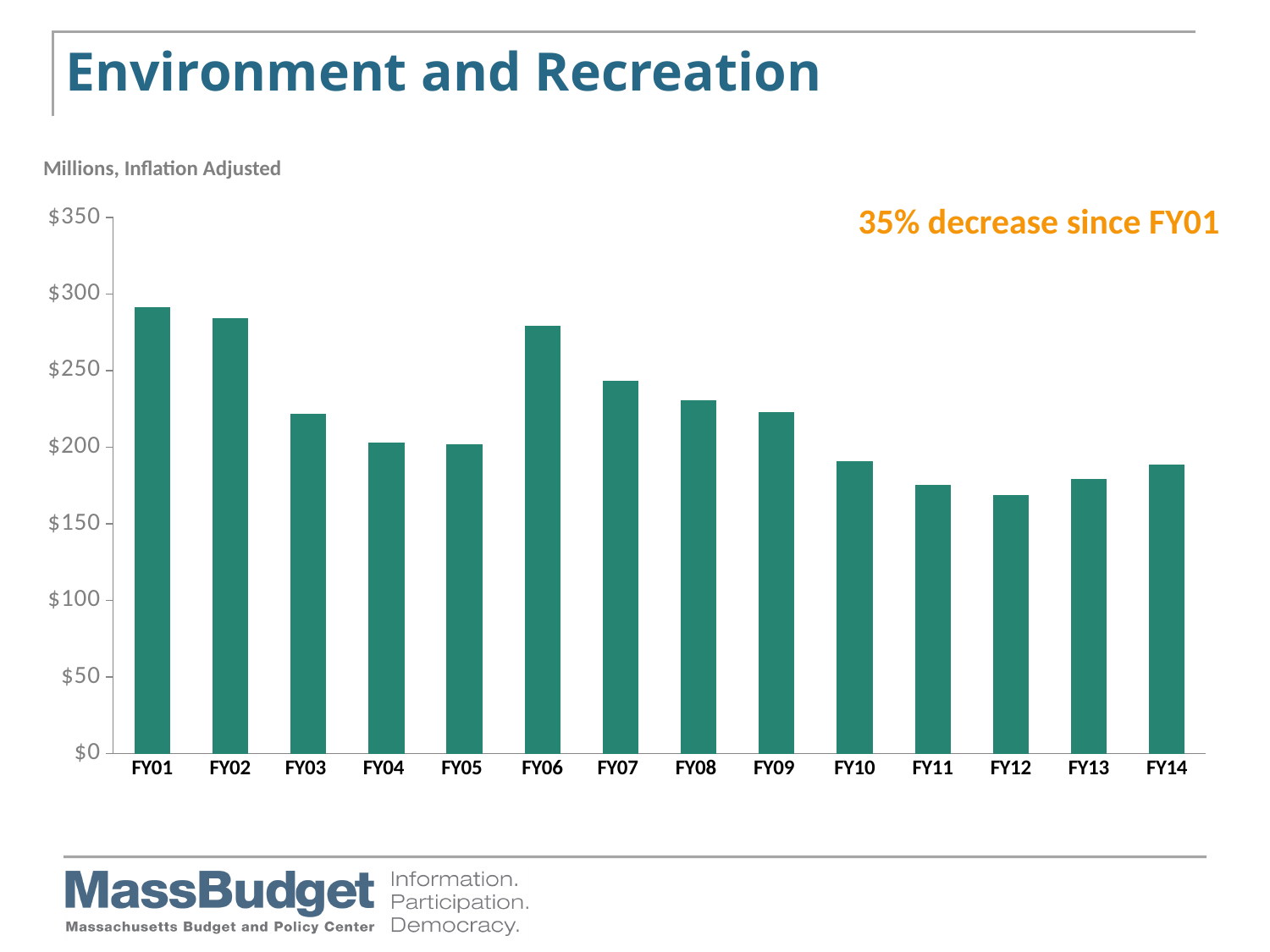
Overall, do the values rise or fall from FY01 to FY14? fall Which is larger, the value for FY06 or the value for FY07? FY06 Is the value for FY03 greater or less than $200? greater Is the value for FY06 greater or less than $250? greater Which fiscal year has the highest value on the chart? FY01 Is the value for FY12 greater or less than $200? less What percentage decrease since FY01 does the chart annotation state? 35% Which is larger, the value for FY13 or the value for FY14? FY14 Which fiscal year has the lowest value on the chart? FY12 What kind of chart is shown on the slide? bar chart How many fiscal years are plotted on the chart? 14